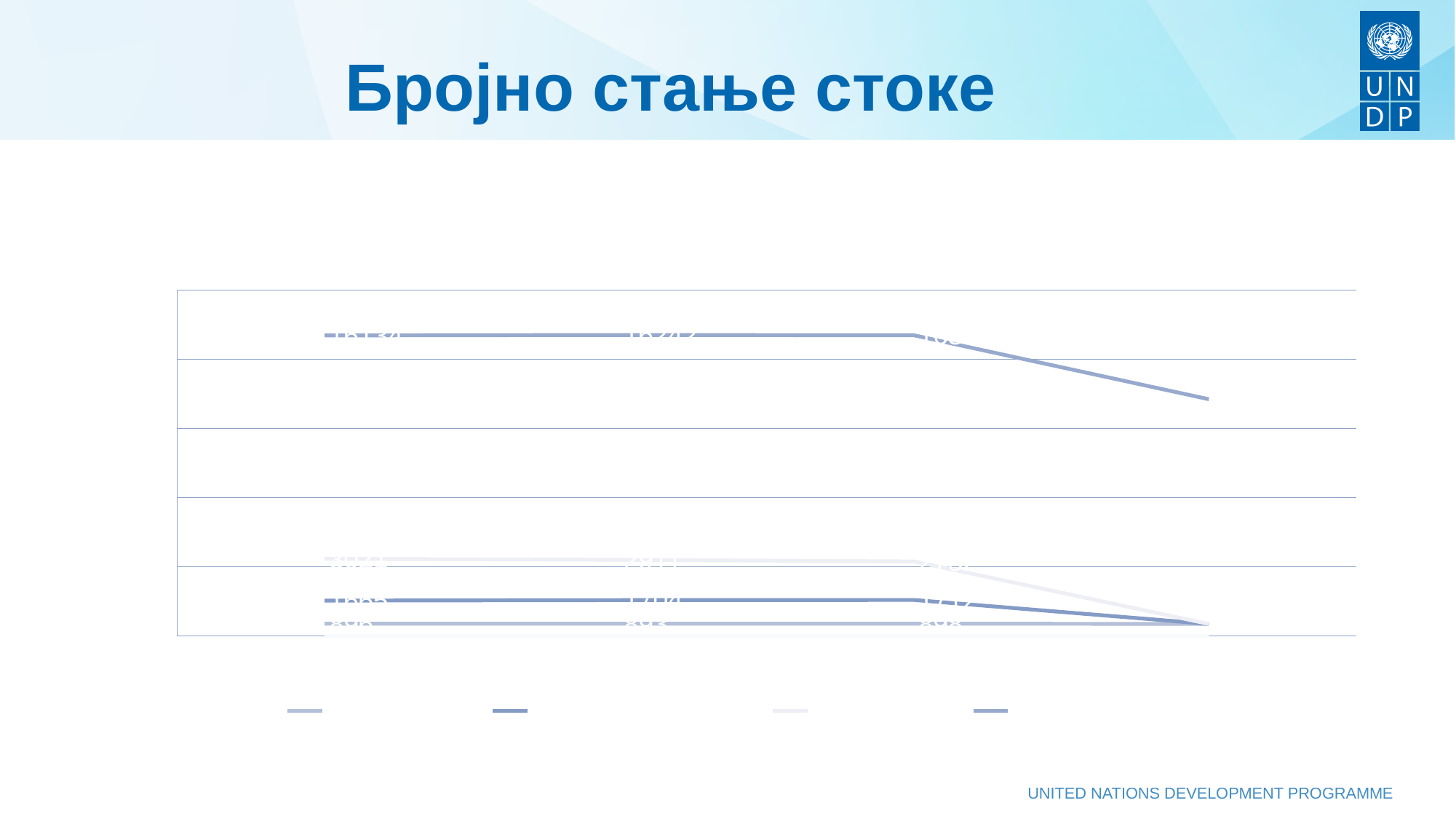
What is the title shown at the top of the slide containing the chart? Бројно стање стоке What kind of chart is shown on the slide? line chart How many series does the legend below the chart list? 4 Does the top line in the chart rise or fall between its third and fourth points? fall Do the values of the top line rise or fall toward the right end of the x axis? fall